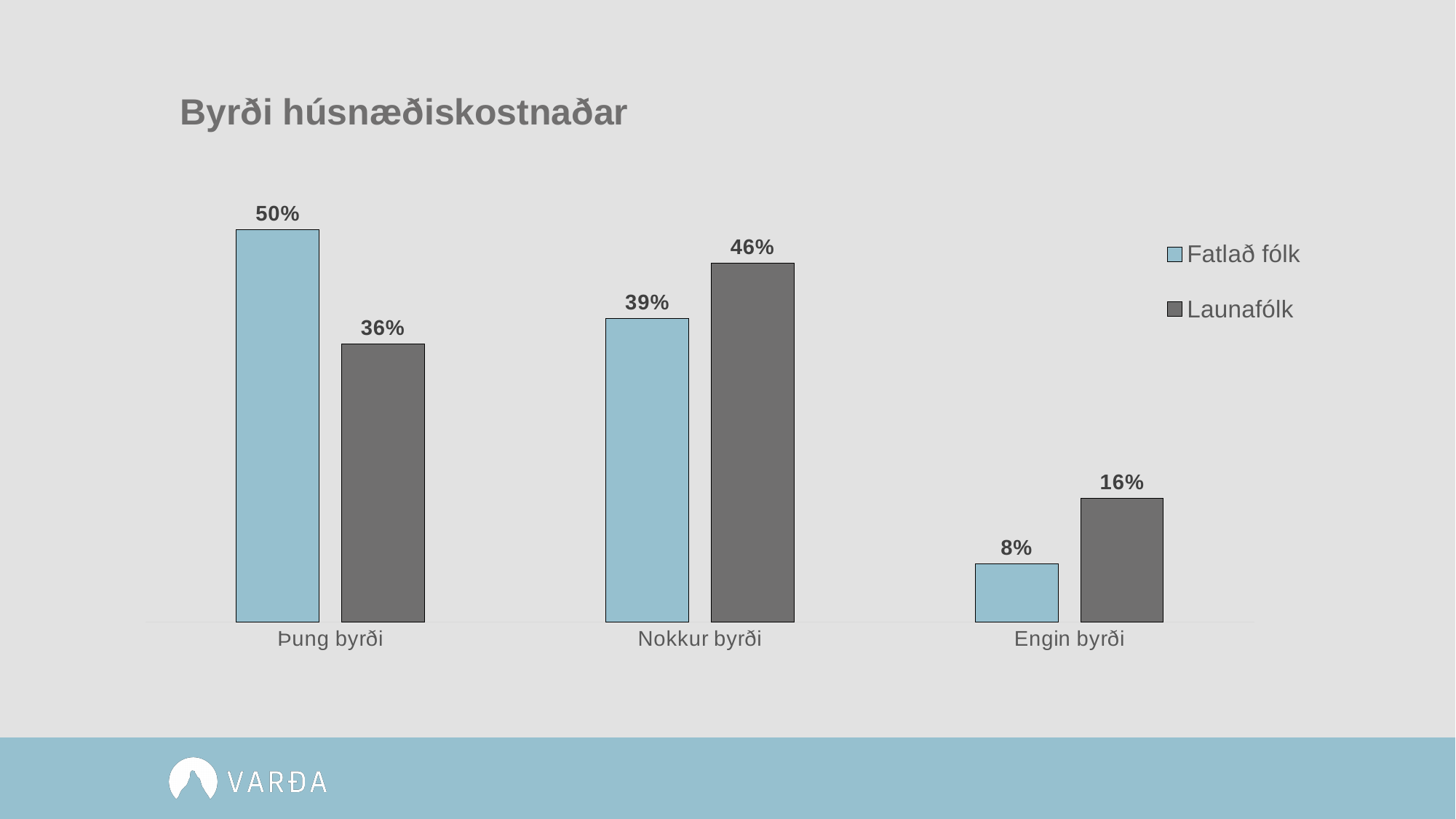
What is the value for Launafólk in the Þung byrði category? 36% What is the difference between Fatlað fólk and Launafólk in the Þung byrði category? 14% What is the value for Fatlað fólk in the Þung byrði category? 50% In the Nokkur byrði category, which series has the larger value, Fatlað fólk or Launafólk? Launafólk Which category has the lowest value for Launafólk? Engin byrði What is the title of the chart? Byrði húsnæðiskostnaðar What is the value for Fatlað fólk in the Engin byrði category? 8% How many categories are shown on the x axis? 3 How many series does the legend list? 2 What is the difference between Launafólk and Fatlað fólk in the Engin byrði category? 8% What is the value for Launafólk in the Nokkur byrði category? 46% Which category has the highest value for Fatlað fólk? Þung byrði